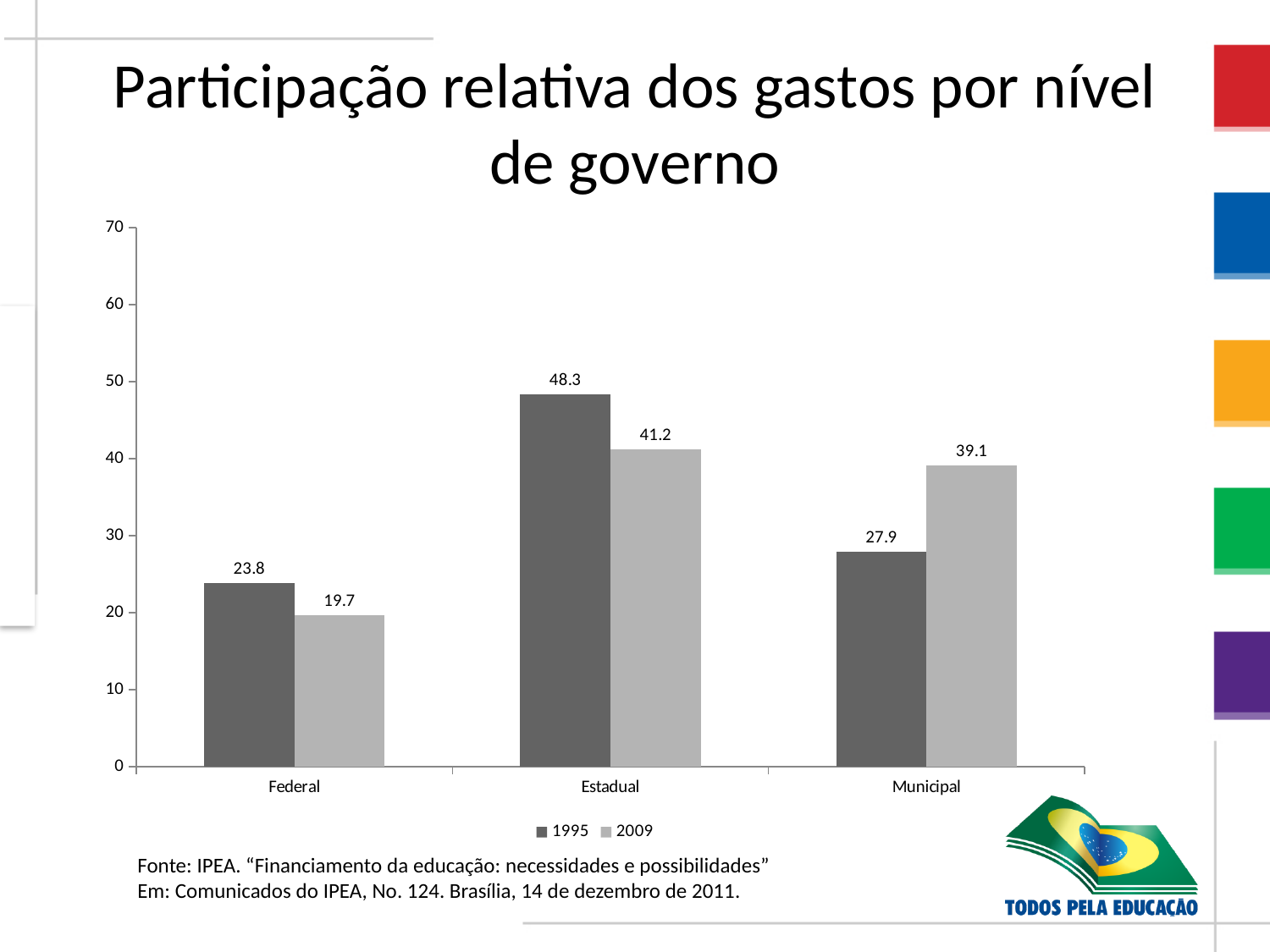
What is the difference between the 1995 and 2009 values for Estadual? 7.1 What kind of chart is shown on the slide? Bar chart How many series does the legend list? 2 Which series is shown in the darker grey bars? 1995 Which is larger for Federal: the 1995 value or the 2009 value? 1995 What is the difference between the 1995 and 2009 values for Municipal? 11.2 What is the value for Municipal in 2009? 39.1 Which level of government has the lowest value in 2009? Federal How many levels of government are shown on the x axis? 3 What is the value for Federal in 2009? 19.7 What is the value for Estadual in 1995? 48.3 Which level of government has the highest value in 1995? Estadual